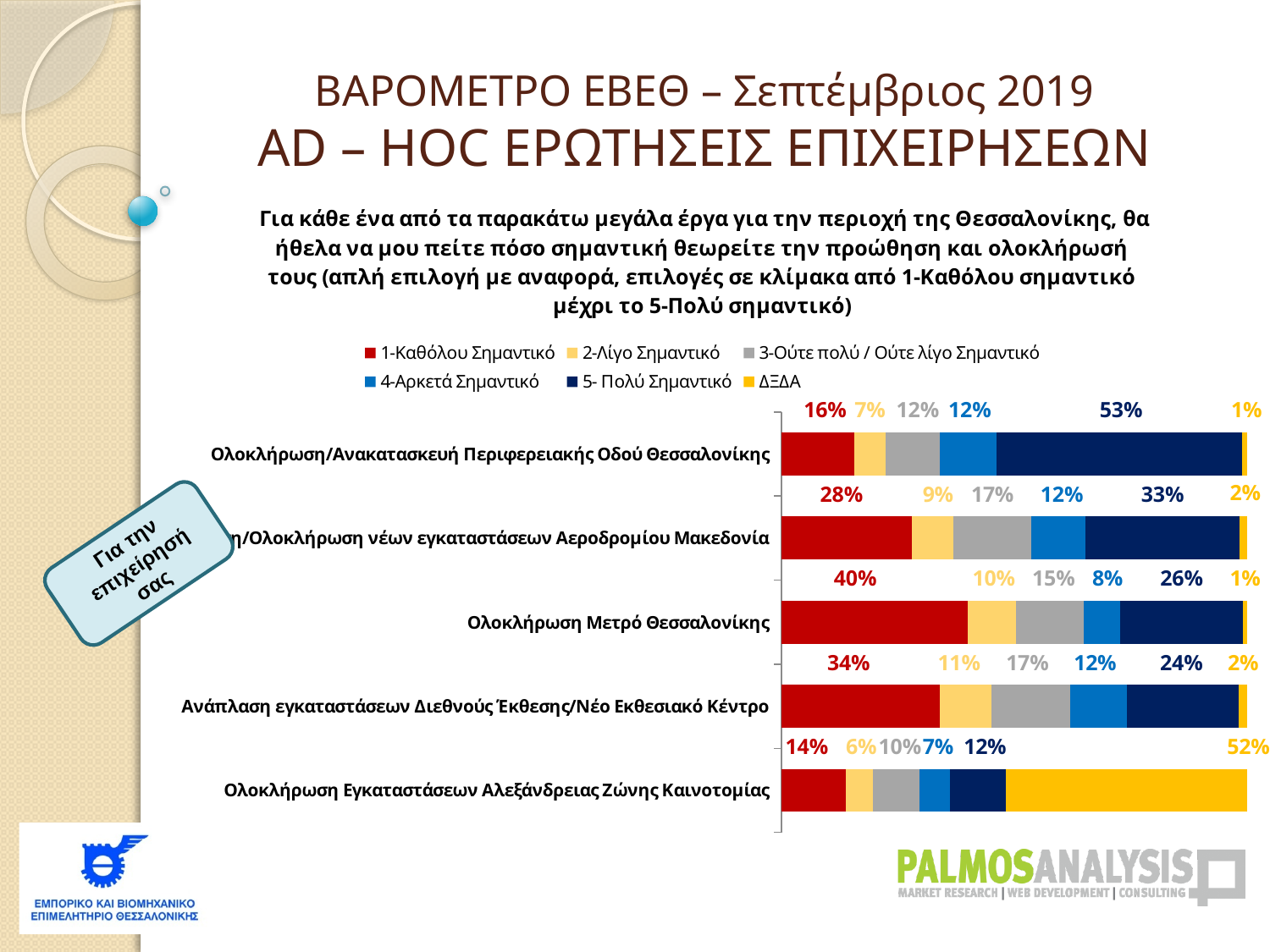
Which is larger: the 1-Καθόλου Σημαντικό value for Αεροδρομίου Μακεδονία or for Ανάπλαση εγκαταστάσεων Διεθνούς Έκθεσης/Νέο Εκθεσιακό Κέντρο? Ανάπλαση εγκαταστάσεων Διεθνούς Έκθεσης/Νέο Εκθεσιακό Κέντρο Which project has the lowest 5-Πολύ Σημαντικό percentage? Ολοκλήρωση Εγκαταστάσεων Αλεξάνδρειας Ζώνης Καινοτομίας What percentage of respondents rated the Ολοκλήρωση Μετρό Θεσσαλονίκης as 1-Καθόλου Σημαντικό? 40% What type of chart is shown on the slide? Stacked bar chart What is the 5-Πολύ Σημαντικό value for Ολοκλήρωση/Ανακατασκευή Περιφερειακής Οδού Θεσσαλονίκης? 53% What is the ΔΞΔΑ value for Ολοκλήρωση Εγκαταστάσεων Αλεξάνδρειας Ζώνης Καινοτομίας? 52% How many series does the legend list? 6 How many projects (categories) are shown in the chart? 5 What is the difference between the 5-Πολύ Σημαντικό values for Περιφερειακής Οδού Θεσσαλονίκης and Αεροδρομίου Μακεδονία? 20 percentage points Which legend entry is shown in red? 1-Καθόλου Σημαντικό What is the 3-Ούτε πολύ / Ούτε λίγο Σημαντικό value for Ανάπλαση εγκαταστάσεων Διεθνούς Έκθεσης/Νέο Εκθεσιακό Κέντρο? 17% Which project has the highest 1-Καθόλου Σημαντικό percentage? Ολοκλήρωση Μετρό Θεσσαλονίκης